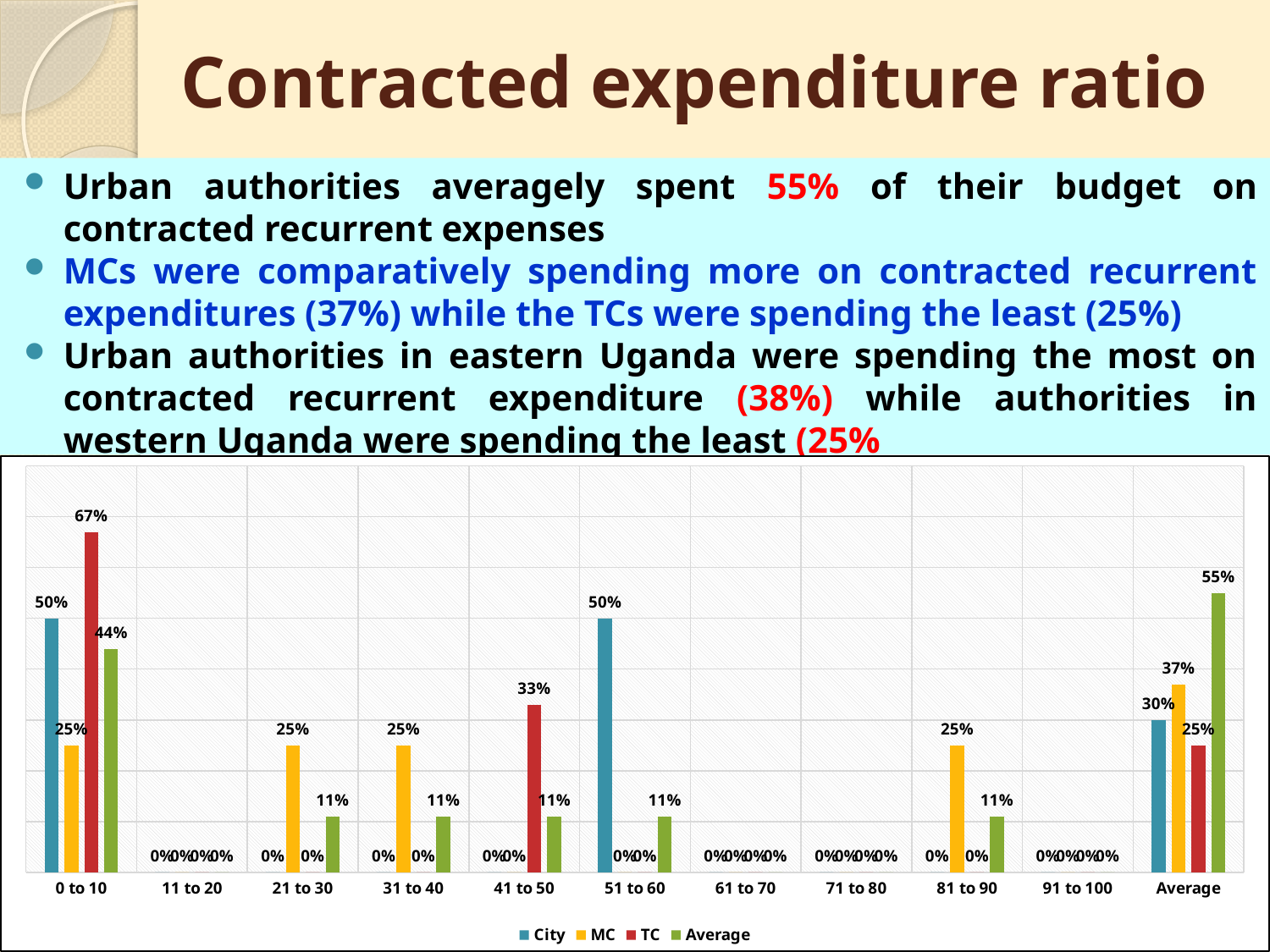
How many series does the chart legend list? 4 How many categories are shown along the x axis of the chart? 11 Which series is shown in red in the chart legend? TC Which series has the highest value in the 0 to 10 category? TC What is the MC value in the Average category? 37% What is the TC value for the 0 to 10 category? 67% Which series has the lowest value in the Average category? TC What is the difference between the TC value and the City value in the 0 to 10 category? 17% What is the City value for the 51 to 60 category? 50% What is the TC value for the 41 to 50 category? 33% In the Average category, which is larger: the City value or the MC value? MC What kind of chart is shown on the slide? bar chart